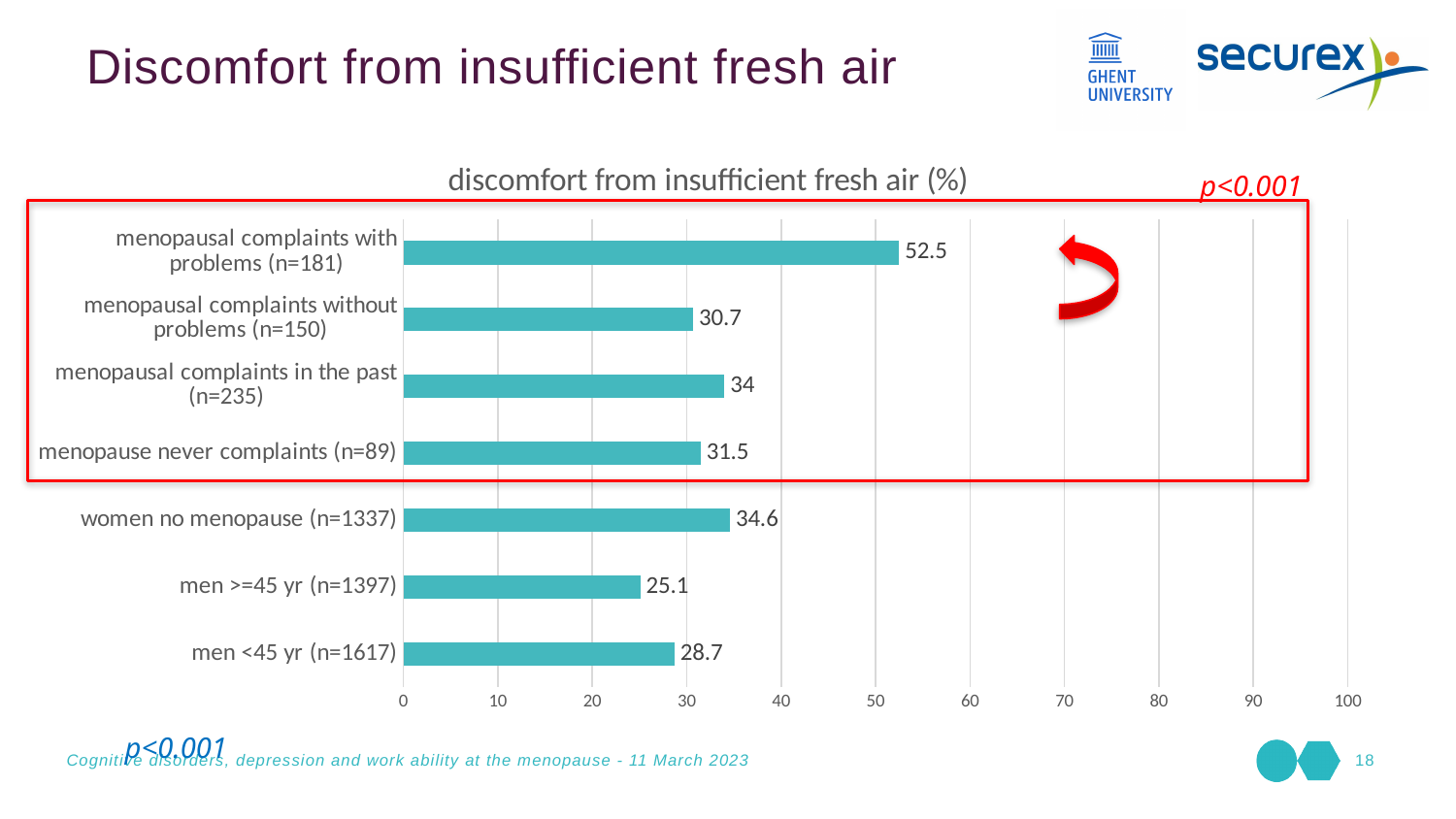
What is the value for men <45 yr (n=1617)? 28.7 Which is larger: the value for menopausal complaints in the past (n=235) or menopause never complaints (n=89)? menopausal complaints in the past (n=235) Which category has the lowest value? men >=45 yr (n=1397) What is the difference between menopausal complaints with problems (n=181) and menopausal complaints without problems (n=150)? 21.8 What is the value for women no menopause (n=1337)? 34.6 What is the maximum value shown on the x axis? 100 What is the value for menopausal complaints with problems (n=181)? 52.5 Which category has the highest value? menopausal complaints with problems (n=181) What is the title of the chart? discomfort from insufficient fresh air (%) Is the value for men >=45 yr (n=1397) greater or less than 30? less How many categories are shown in the chart? 7 What kind of chart is shown? bar chart